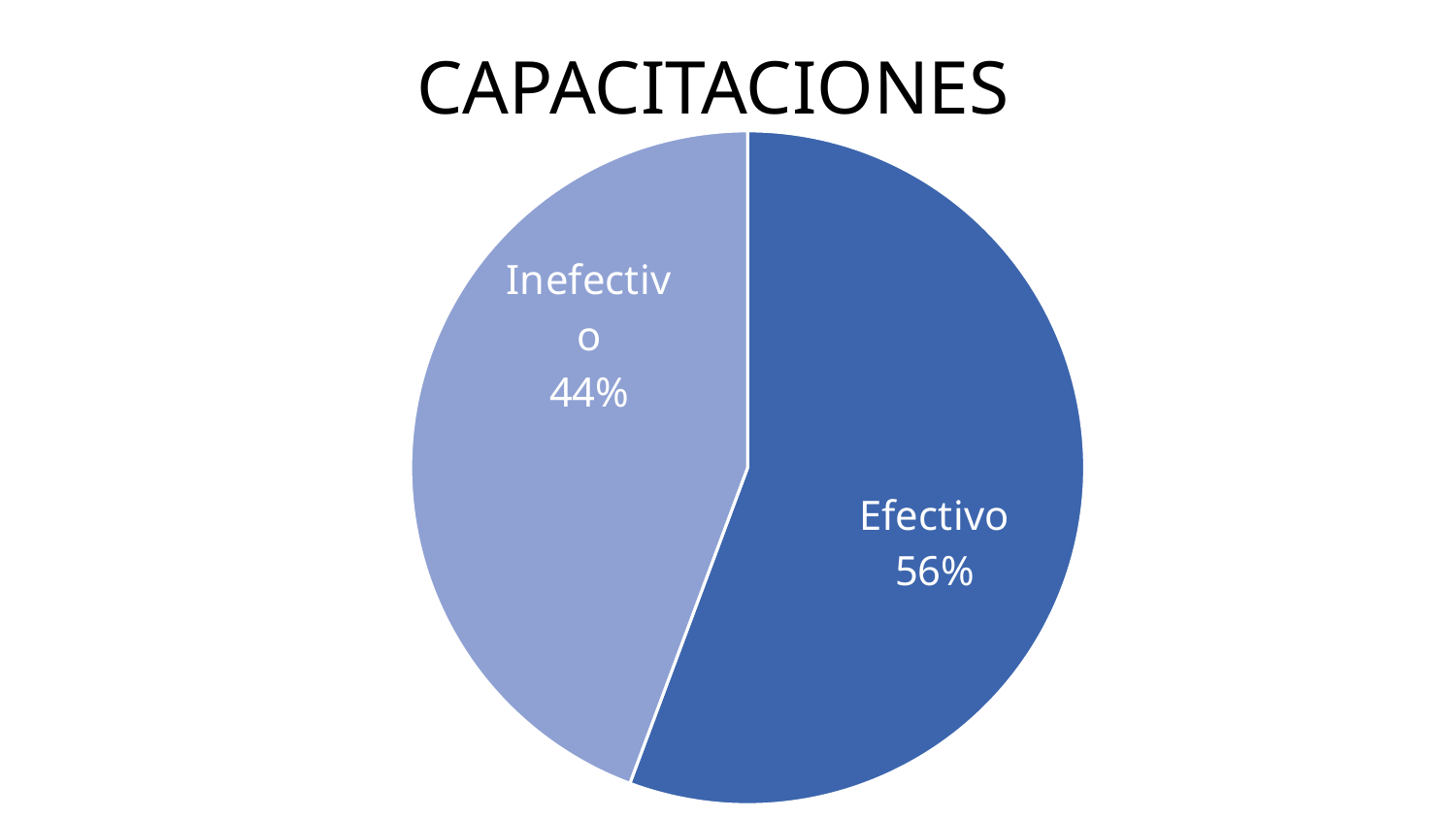
Which slice is shown in the darker blue colour? Efectivo What is the difference in percentage points between Efectivo and Inefectivo? 12 What percentage is shown for Efectivo? 56% What is the title of the chart? CAPACITACIONES How many slices does the pie chart have? 2 Which is larger, Efectivo or Inefectivo? Efectivo What share of the pie does the Inefectivo slice represent? 44% What percentage is shown for Inefectivo? 44% Is the value for Efectivo greater or less than 50%? greater Which slice is the largest? Efectivo Which slice is the smallest? Inefectivo What kind of chart is shown on the slide? Pie chart